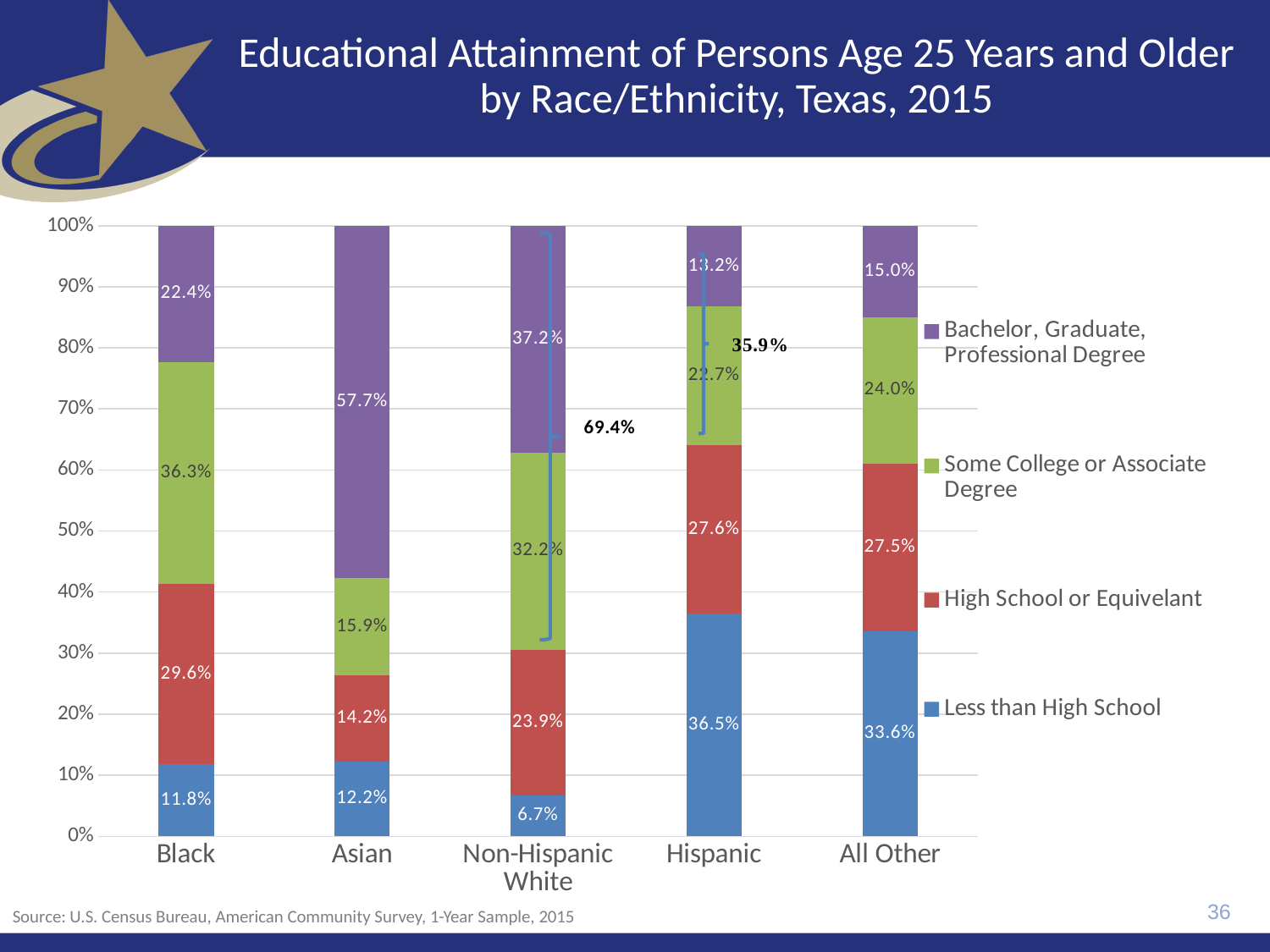
How many series does the legend list? 4 What percentage of Non-Hispanic White persons have Less than High School? 6.7% What percentage of Black persons have Some College or Associate Degree? 36.3% How many race/ethnicity categories are shown on the x axis? 5 According to the annotation, what is the combined share of Non-Hispanic White persons with Some College or Associate Degree or a Bachelor, Graduate, Professional Degree? 69.4% Which race/ethnicity group has the highest share with Less than High School? Hispanic What percentage of Asian persons have a Bachelor, Graduate, or Professional Degree? 57.7% What type of chart is shown on the slide? Stacked bar chart What percentage of All Other persons have High School or Equivelant? 27.5% What is the difference between the Bachelor, Graduate, Professional Degree share for Asian and for Black persons? 35.3% Which is larger: the High School or Equivelant share for Black persons or for Asian persons? Black Which race/ethnicity group has the lowest share with a Bachelor, Graduate, or Professional Degree? Hispanic